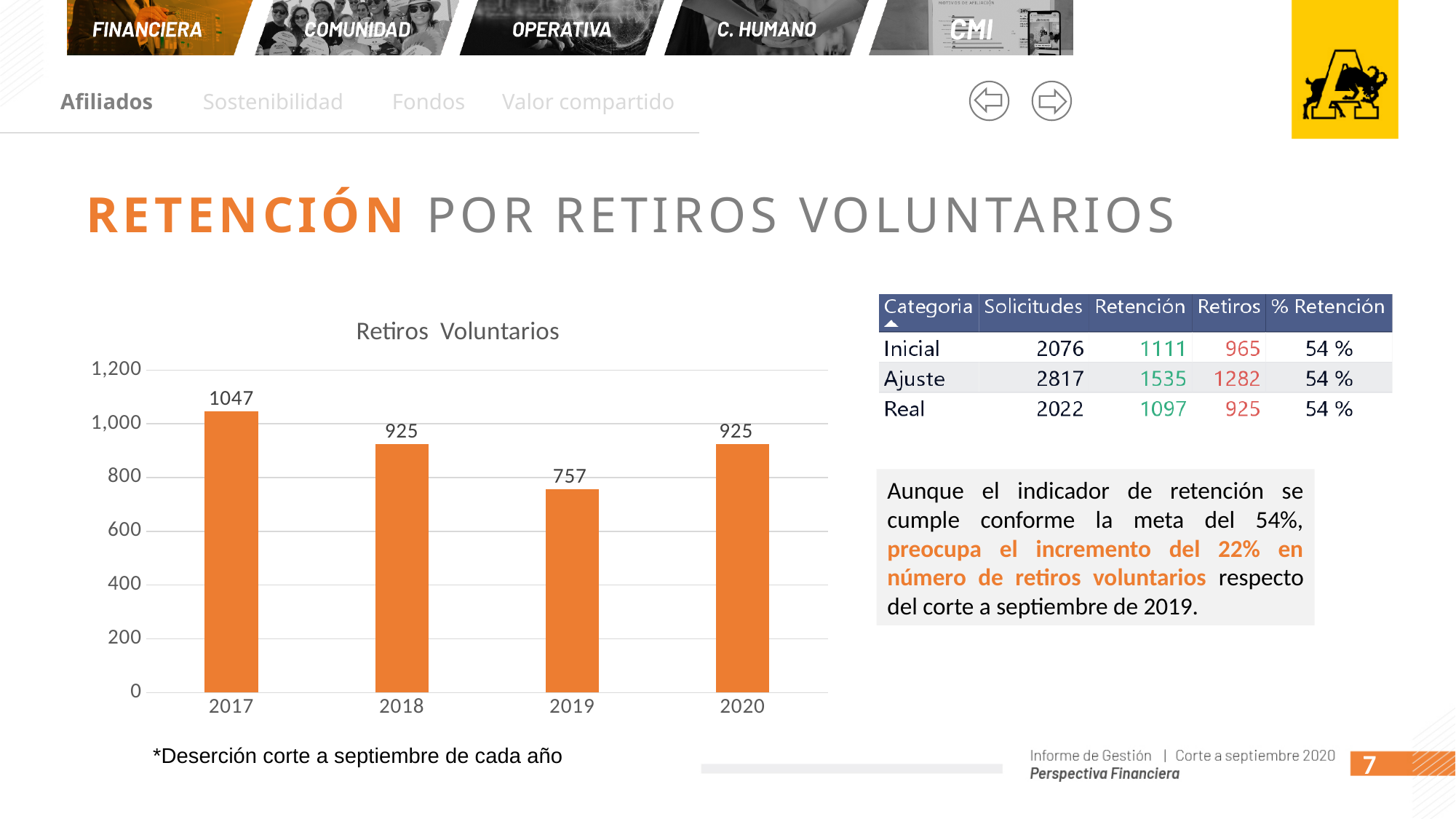
What is the value for 2019 in the Retiros Voluntarios chart? 757 What is the value for 2017 in the Retiros Voluntarios chart? 1047 How many years are shown in the Retiros Voluntarios chart? 4 Which year has the lowest value in the Retiros Voluntarios chart? 2019 What is the value for 2020 in the Retiros Voluntarios chart? 925 What is the difference between the 2020 and 2019 values in the Retiros Voluntarios chart? 168 What is the title of the chart on the slide? Retiros Voluntarios Which is larger in the Retiros Voluntarios chart, the value for 2017 or the value for 2018? 2017 Is the value for 2019 in the Retiros Voluntarios chart greater or less than 800? less What is the difference between the 2017 and 2019 values in the Retiros Voluntarios chart? 290 What kind of chart is the Retiros Voluntarios chart? bar chart Which year has the highest value in the Retiros Voluntarios chart? 2017